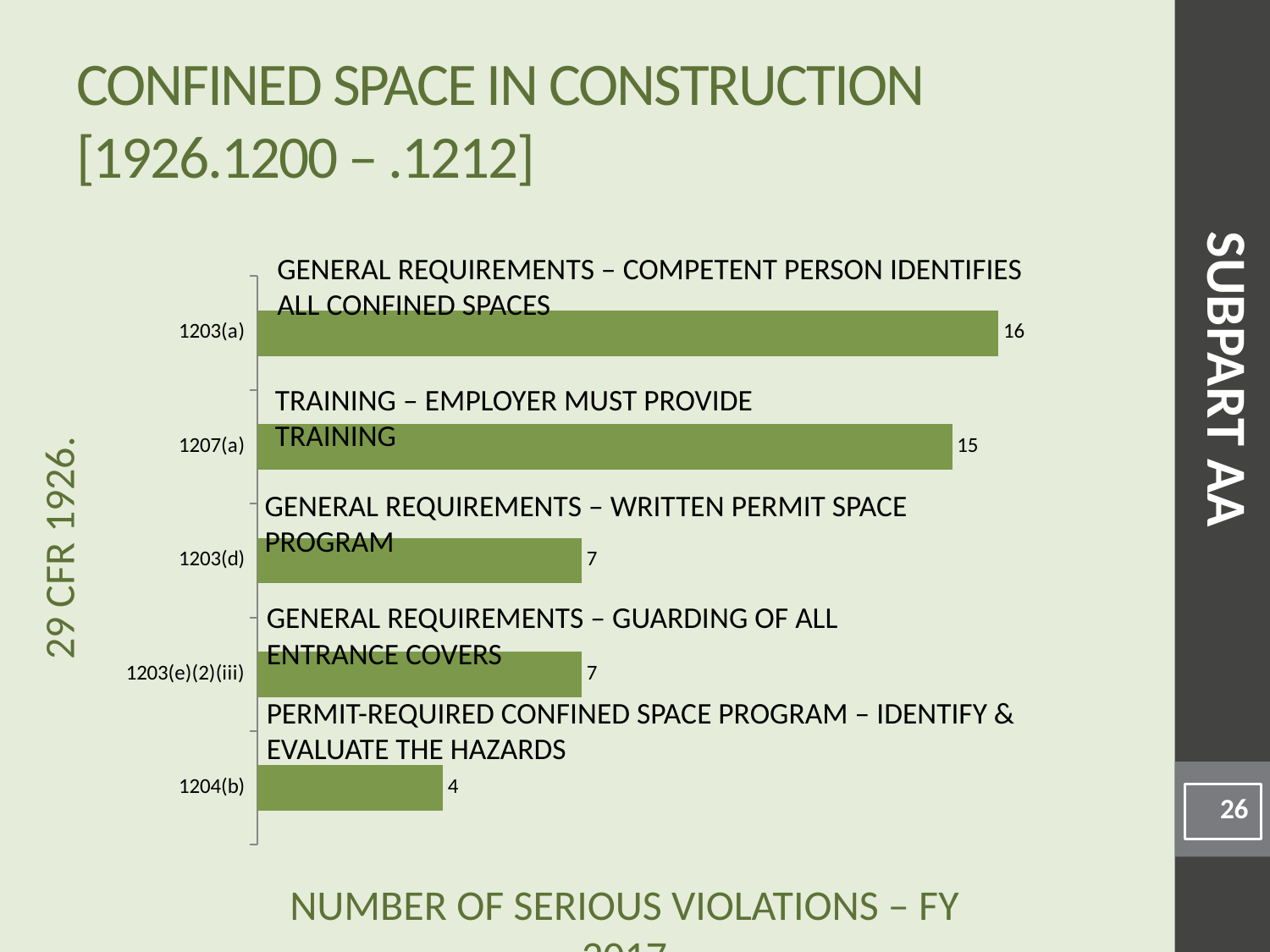
What is the difference between the number of serious violations for 1203(a) and 1204(b)? 12 What is the number of serious violations for 1203(a)? 16 What is the number of serious violations for 1204(b)? 4 What is the difference between the number of serious violations for 1207(a) and 1203(d)? 8 Which has more serious violations, 1203(a) or 1207(a)? 1203(a) What is the number of serious violations for 1203(d)? 7 How many standards (categories) are shown in the chart? 5 What kind of chart is shown on the slide? Bar chart What is the number of serious violations for 1207(a)? 15 Which standard has the highest number of serious violations? 1203(a) What is the label on the vertical axis of the chart? 29 CFR 1926. Which standard has the lowest number of serious violations? 1204(b)